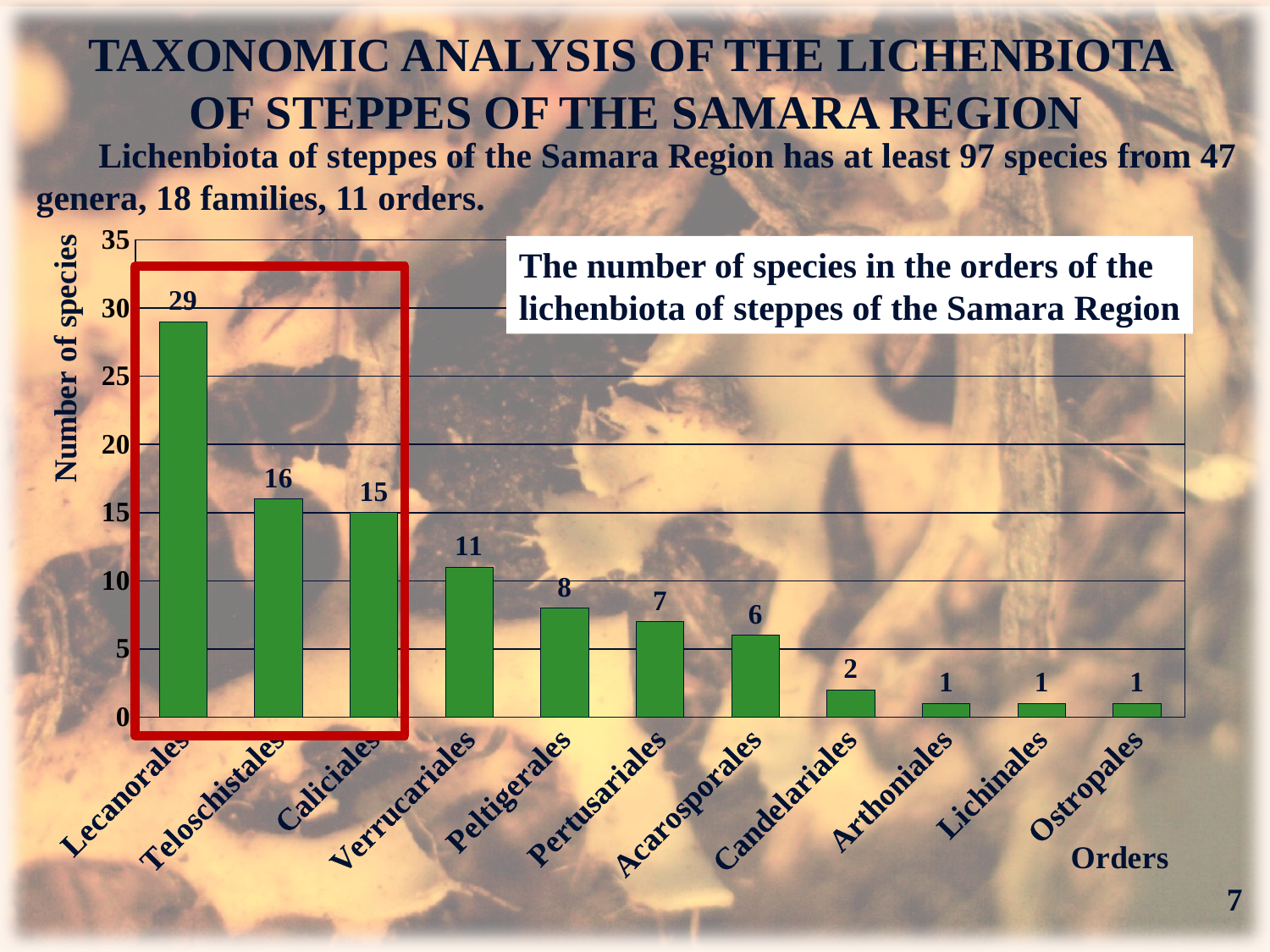
How many species does the chart show for Lecanorales? 29 Do the values rise or fall from left to right along the x axis? Fall How many orders are enclosed by the red rectangle on the chart? 3 What type of chart is shown on the slide? Bar chart How many orders are shown on the x axis of the chart? 11 What is the label of the vertical axis of the chart? Number of species What is the difference in number of species between Lecanorales and Teloschistales? 13 Which has more species, Pertusariales or Candelariales? Pertusariales What is the number of species for Verrucariales? 11 What is the number of species for Acarosporales? 6 What is the difference in number of species between Caliciales and Peltigerales? 7 Which order has the highest number of species? Lecanorales